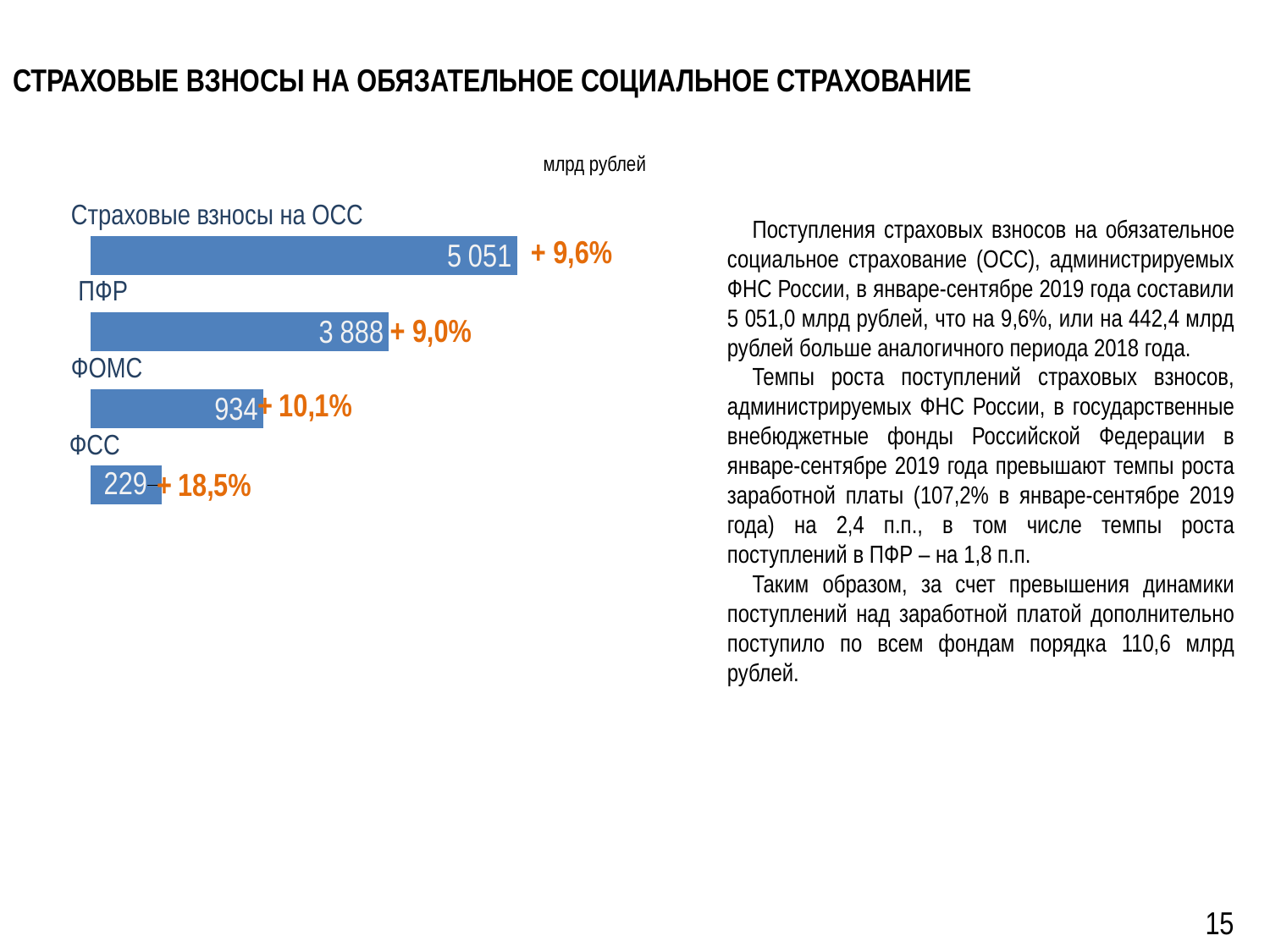
What is the difference between the values for ПФР and ФОМС? 2 954 Which is larger, the value for ФОМС or the value for ФСС? ФОМС What unit is indicated above the chart? млрд рублей What is the value for Страховые взносы на ОСС? 5 051 What is the value for ФСС? 229 Which category has the highest value? Страховые взносы на ОСС What is the value for ФОМС? 934 What kind of chart is shown on the slide? Bar chart Which category has the lowest value? ФСС What is the value for ПФР? 3 888 How many categories are shown in the chart? 4 What growth percentage is shown next to the ФСС bar? + 18,5%